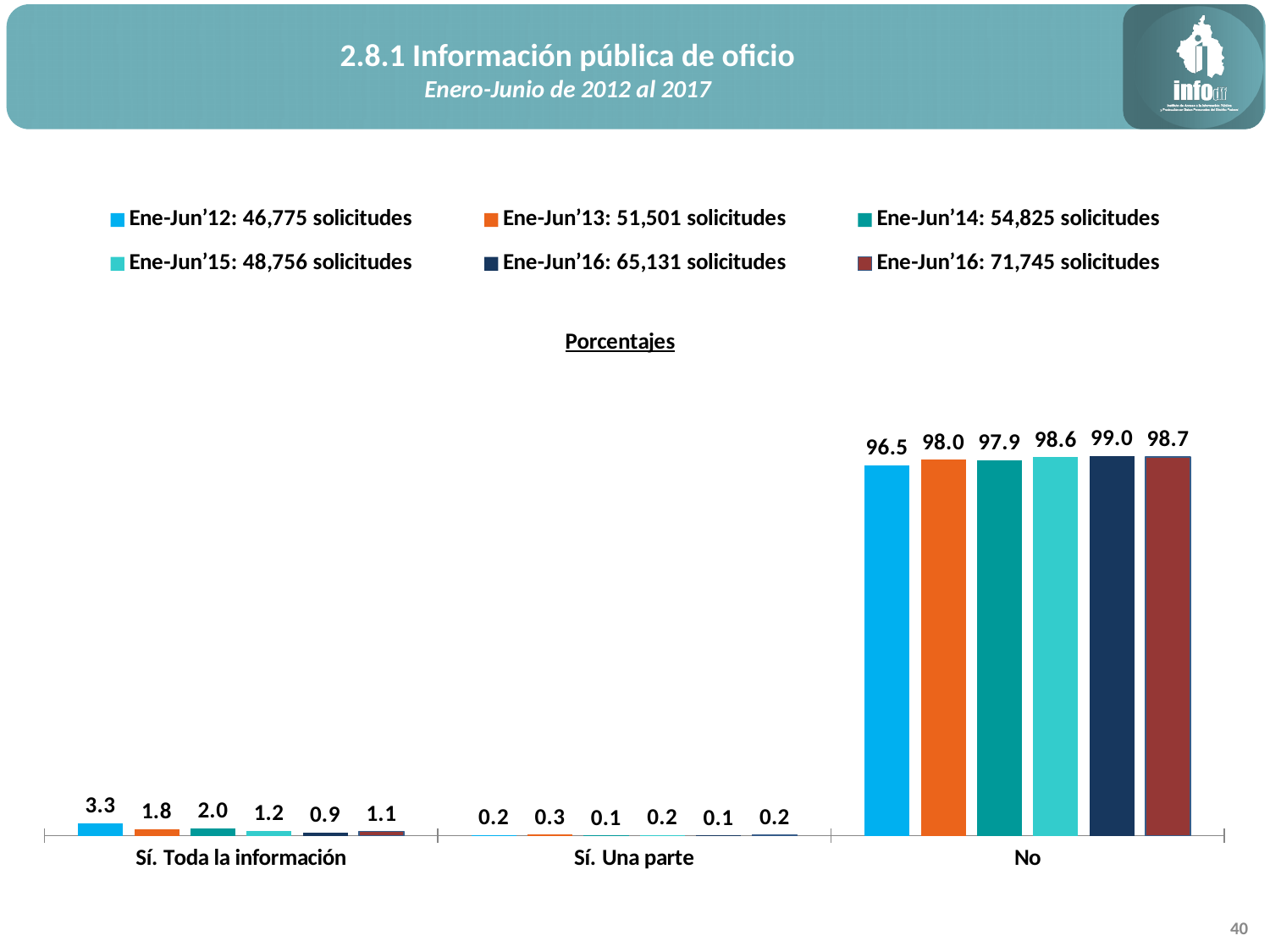
What is the difference between the Ene-Jun'15 and Ene-Jun'12 values in the "No" category? 2.1 According to the legend, how many solicitudes were there in Ene-Jun'14? 54,825 What is the value for Ene-Jun'13 in the "Sí. Toda la información" category? 1.8 How many categories are shown on the x axis of the chart? 3 What is the value for Ene-Jun'15 in the "Sí. Una parte" category? 0.2 What is the value for Ene-Jun'12 in the "No" category? 96.5 How many series does the chart's legend list? 6 What kind of chart is shown on the slide? bar chart Which series has the highest value in the "No" category? Ene-Jun'16: 65,131 solicitudes Which series has the lowest value in the "Sí. Toda la información" category? Ene-Jun'16: 65,131 solicitudes What is the difference between the Ene-Jun'12 and Ene-Jun'13 values in the "Sí. Toda la información" category? 1.5 In the "Sí. Toda la información" category, which is larger: the value for Ene-Jun'14 or for Ene-Jun'15? Ene-Jun'14